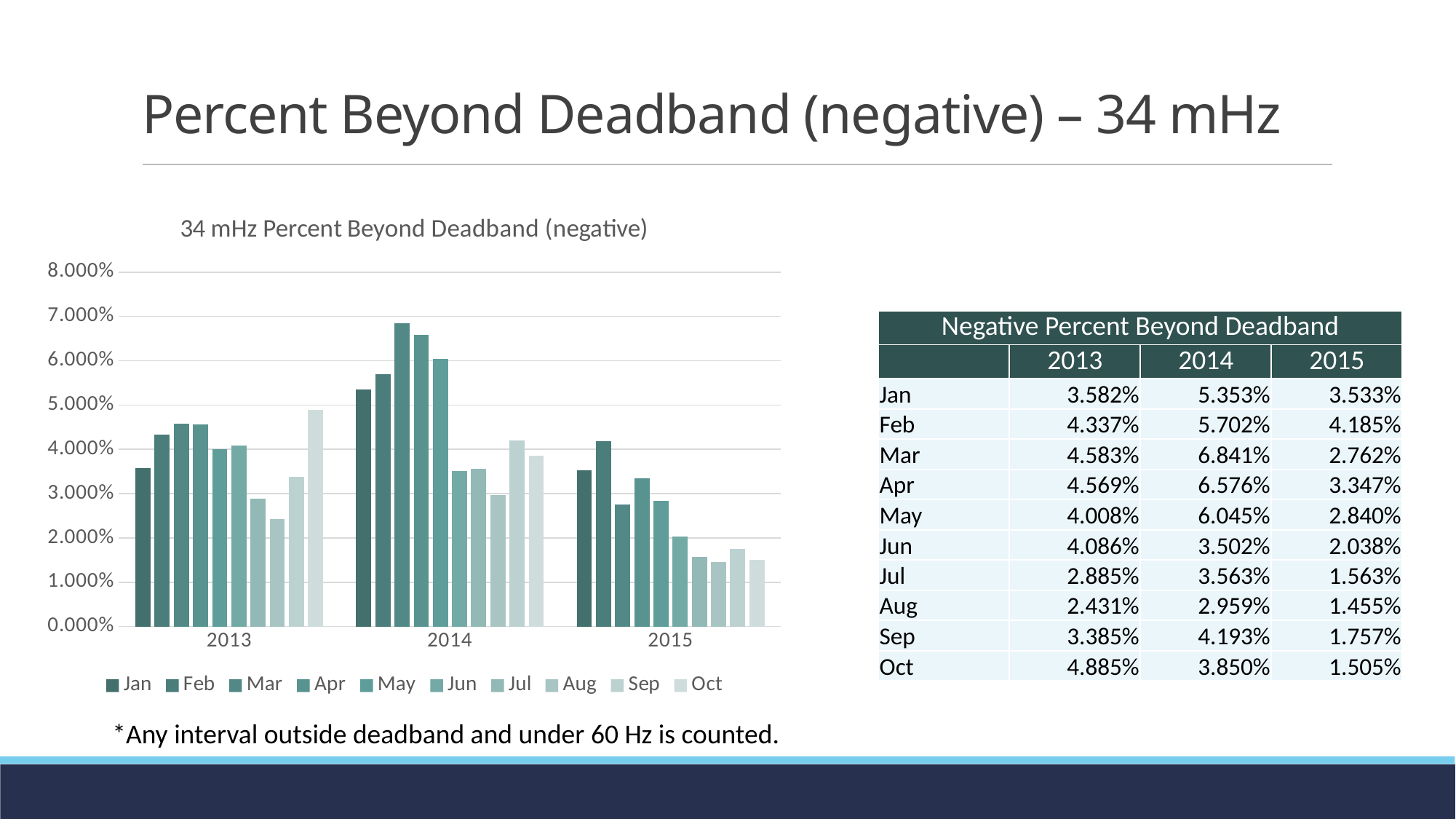
How many year categories are shown on the x axis of the chart? 3 Which month has the lowest bar in the 2013 group? Aug What is the negative percent beyond deadband for Jan 2014? 5.353% In the 2015 group, do the bars generally rise or fall from Jan to Oct? fall How many series does the chart legend list? 10 What kind of chart is shown on the slide? bar chart Is the value for Oct 2015 greater or less than 2.000%? less Which year group contains the tallest bar in the chart? 2014 Which is larger, the Oct value for 2013 or the Oct value for 2014? 2013 What is the difference between the Mar 2014 value and the Mar 2015 value? 4.079% What is the title of the chart? 34 mHz Percent Beyond Deadband (negative) Is the value for Mar 2014 greater or less than 6.000%? greater